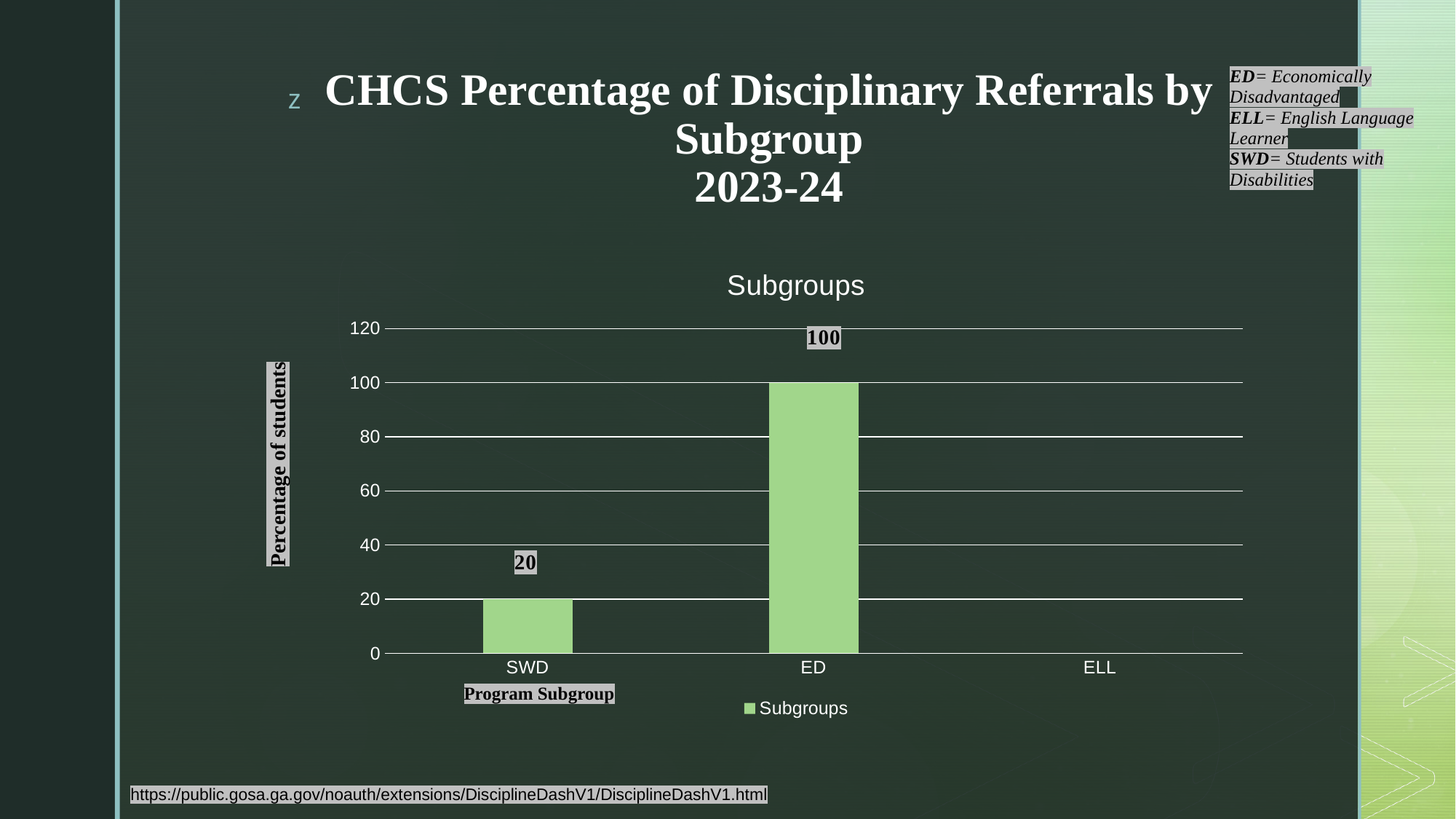
What is the label of the vertical axis of the chart? Percentage of students How many categories are shown on the x axis of the chart? 3 What kind of chart is shown on the slide? bar chart Which is larger, the value for SWD or the value for ED? ED Is the value for ED greater or less than 80? greater What is the value for ED in the Subgroups chart? 100 What is the title of the chart? Subgroups Is the value for SWD greater or less than 40? less How many series does the chart legend list? 1 Which subgroup has the highest value in the chart? ED What is the difference between the values for ED and SWD? 80 What is the value for SWD in the Subgroups chart? 20